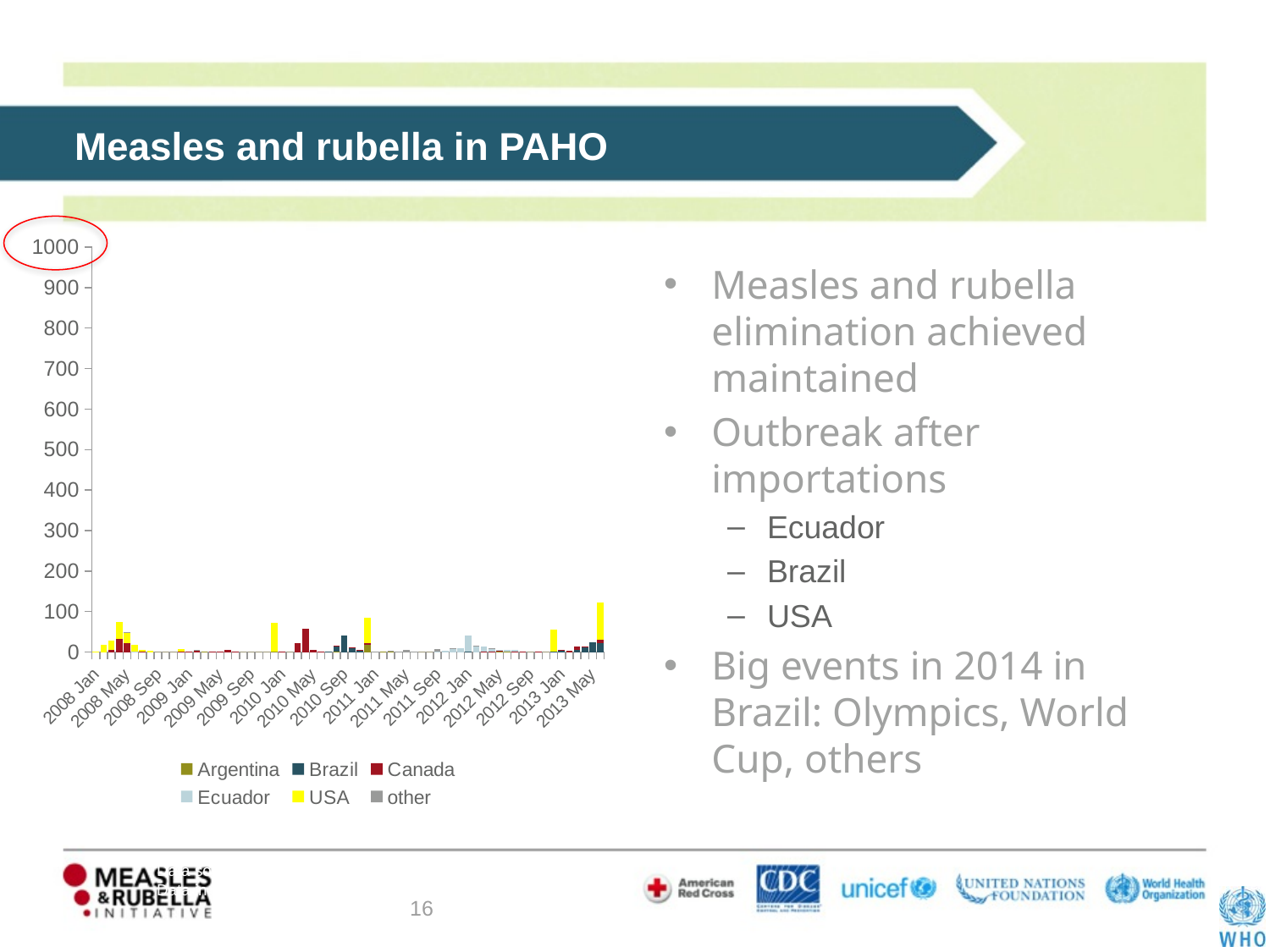
What kind of chart is shown on the slide? Stacked bar chart What colour represents USA in the chart? Yellow Which series are listed in the chart legend? Argentina, Brazil, Canada, Ecuador, USA, other Is the value for 2008 May greater or less than 100? less Is the tallest bar on the chart greater or less than 200? less What is the first month label on the chart's horizontal axis? 2008 Jan Is the value for 2010 Sep greater or less than 300? less Which series has the tallest bars on the chart? USA What is the last month label on the chart's horizontal axis? 2013 May How many series does the chart legend list? 6 What is the highest value shown on the chart's vertical axis? 1000